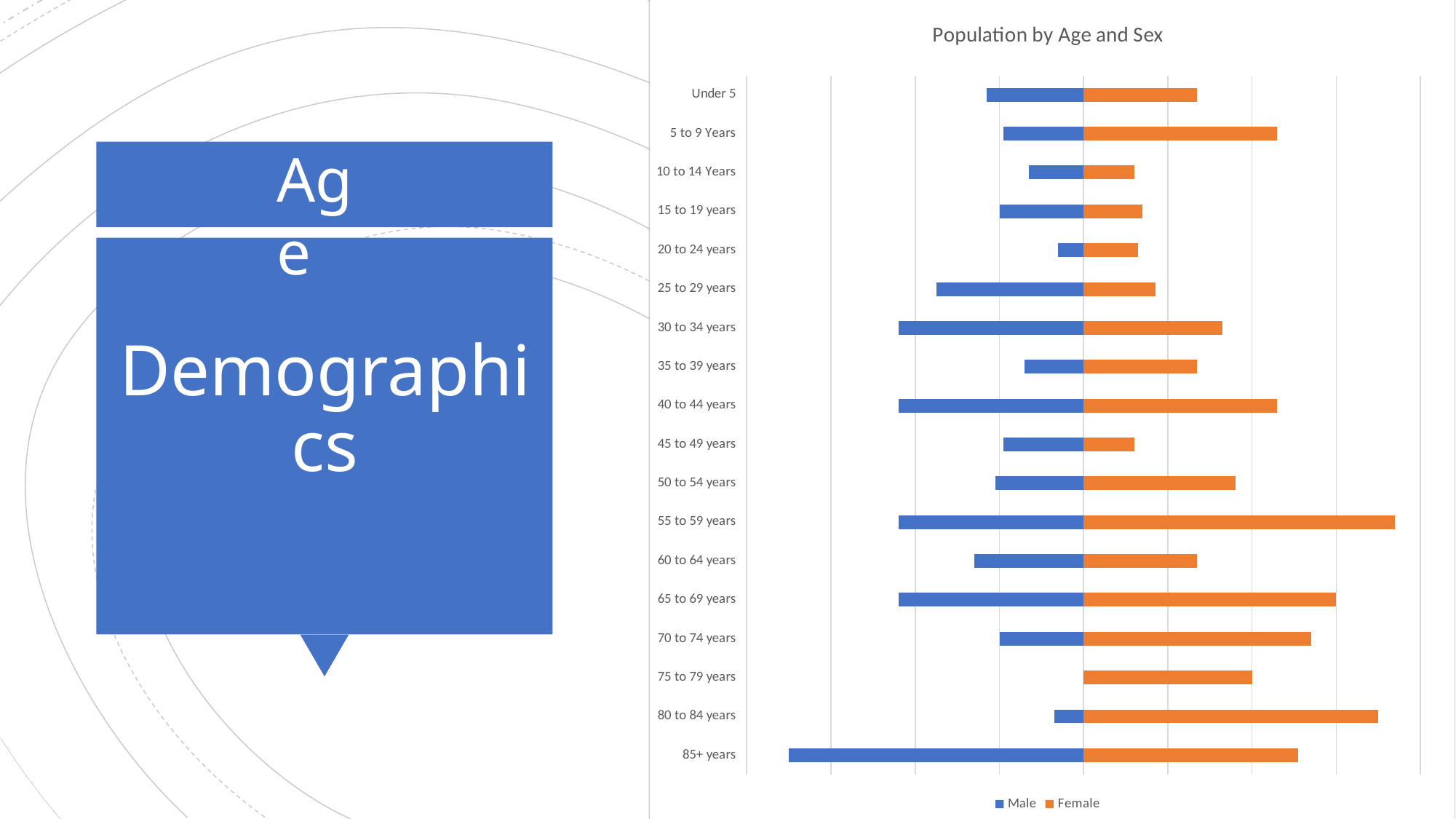
Which is larger, the Male value for 30 to 34 years or for 20 to 24 years? 30 to 34 years Which colour represents the Female series in the chart? orange Which is larger, the Female value for 5 to 9 Years or for 10 to 14 Years? 5 to 9 Years How many series does the legend list? 2 Which is larger, the Male value for 85+ years or for 55 to 59 years? 85+ years How many age categories are plotted on the chart? 18 Which age group has the smallest Male value? 75 to 79 years What is the title of the chart? Population by Age and Sex What kind of chart is shown on the slide? bar chart Which age group has the largest Male value? 85+ years